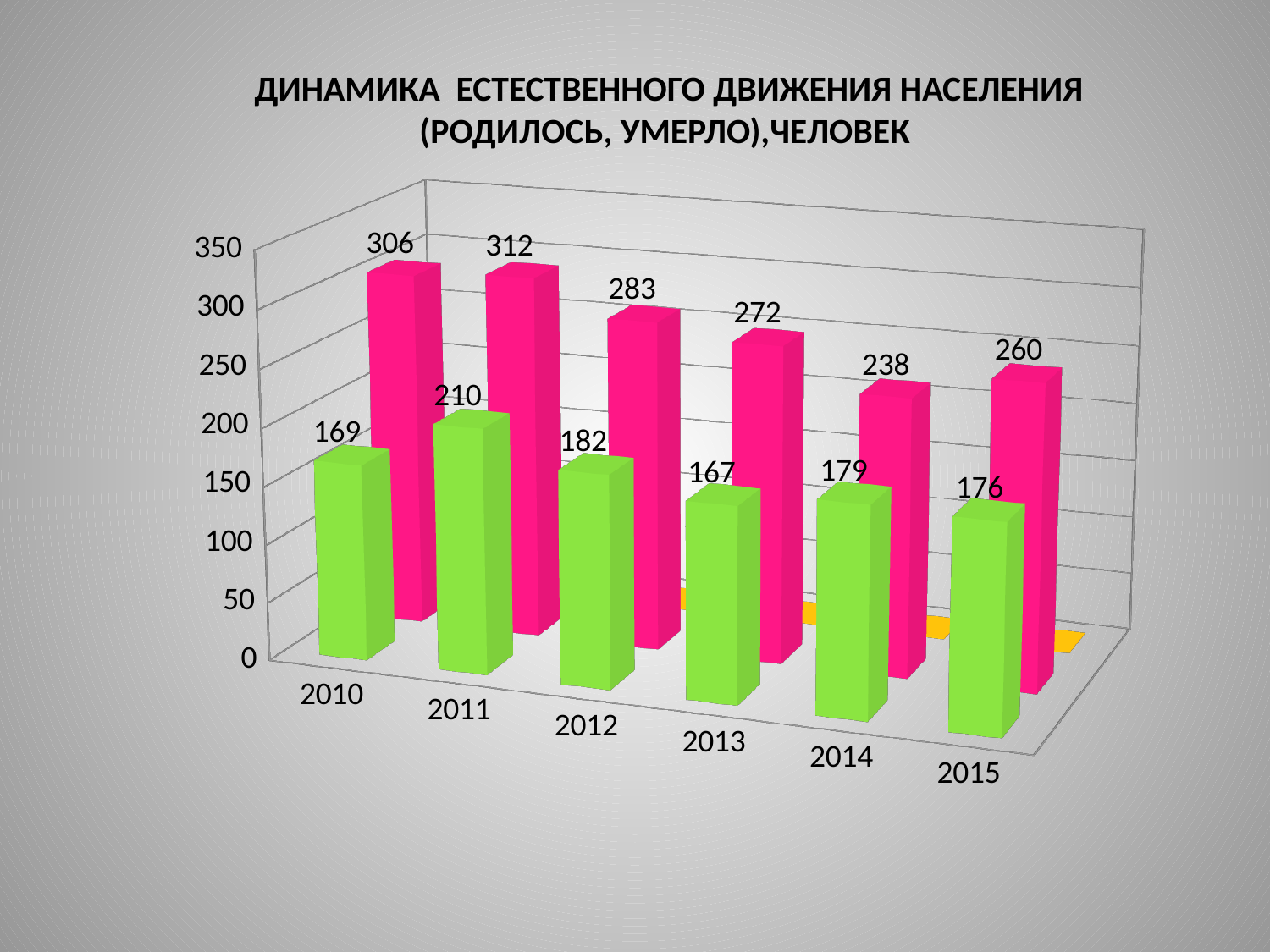
What is the value of the green bar for 2015? 176 What is the value of the pink bar for 2012? 283 For 2014, which bar is larger, the pink one or the green one? the pink one In which year is the green bar the lowest? 2013 How many years are shown on the x axis? 6 Do the pink bar values generally rise or fall from 2010 to 2015? fall What is the title of the chart? ДИНАМИКА ЕСТЕСТВЕННОГО ДВИЖЕНИЯ НАСЕЛЕНИЯ (РОДИЛОСЬ, УМЕРЛО),ЧЕЛОВЕК What kind of chart is shown on the slide? bar chart What is the value of the green bar for 2011? 210 What is the difference between the pink and green bar values for 2013? 105 What is the difference between the pink bar values for 2010 and 2015? 46 In which year is the pink bar the highest? 2011